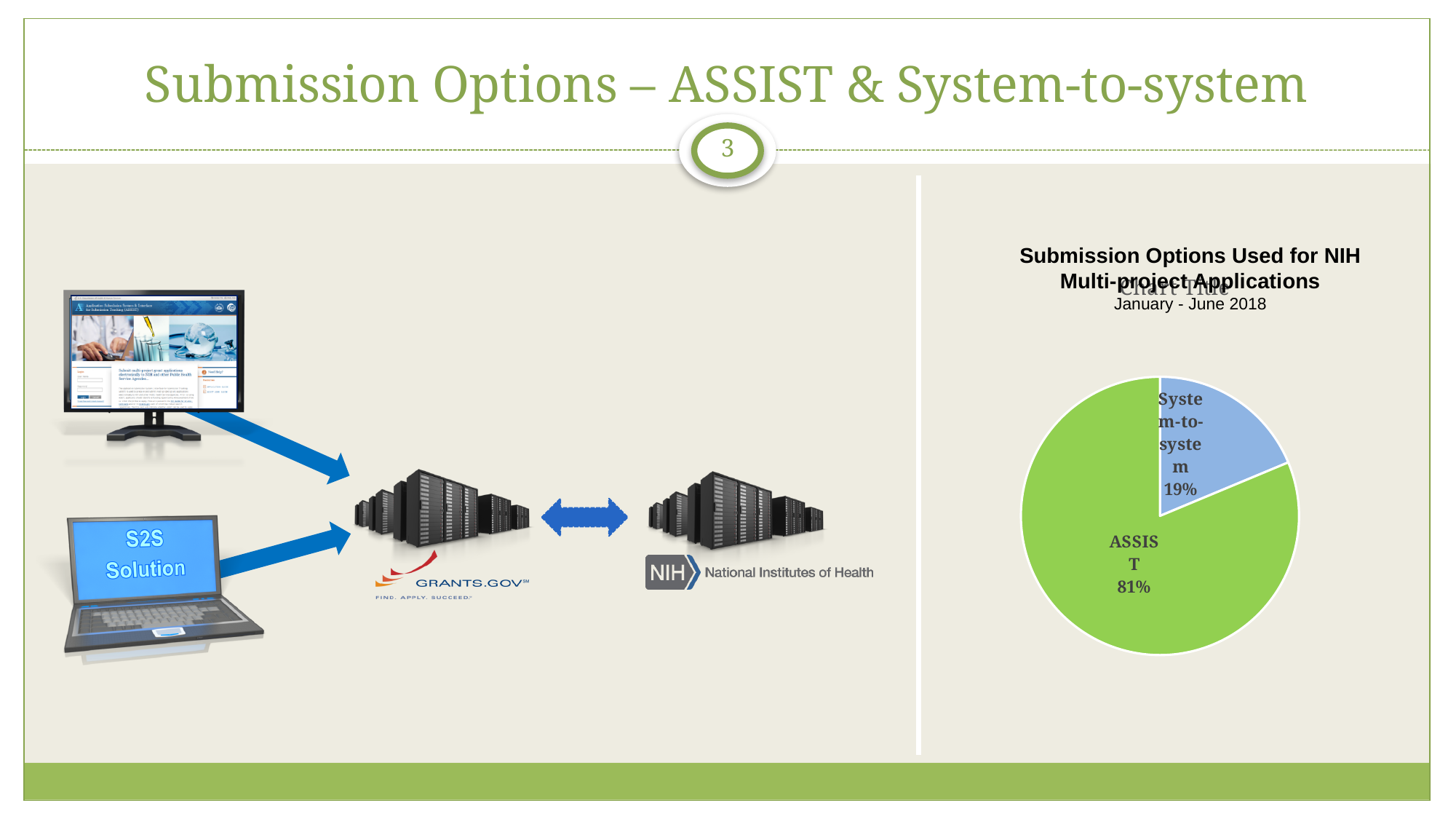
Which submission option has the smallest slice of the pie? System-to-system What is the difference in percentage points between the ASSIST and System-to-system slices? 62 What time period does the chart cover, according to its subtitle? January - June 2018 What colour is the ASSIST slice of the pie? green How many slices does the pie chart have? 2 Which submission option has the largest slice of the pie? ASSIST What share of the pie does System-to-system represent? 19% What share of the pie does ASSIST represent? 81% Which is larger, the ASSIST slice or the System-to-system slice? ASSIST What kind of chart is shown on the slide? pie chart